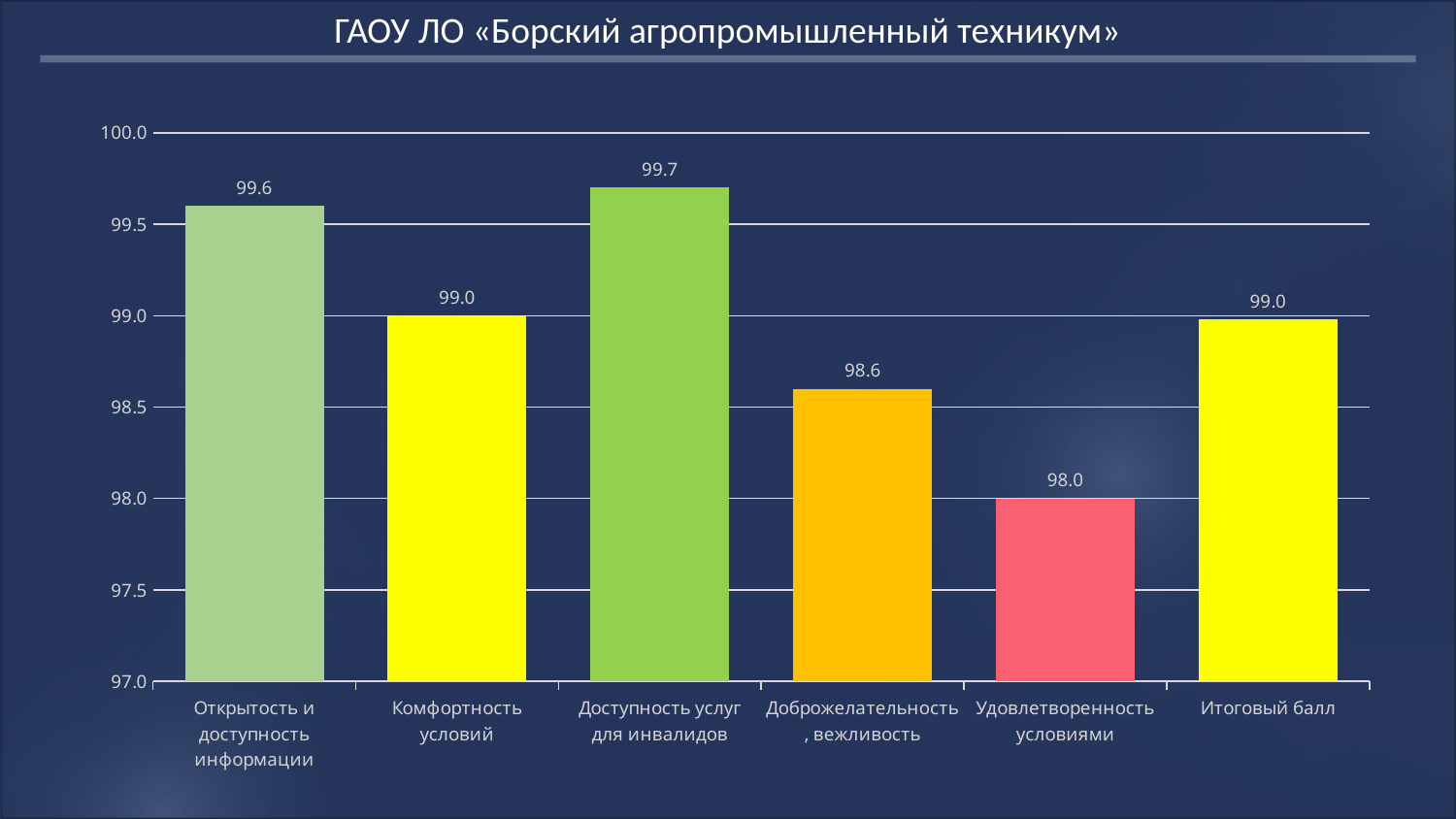
What is the difference between the values for «Доступность услуг для инвалидов» and «Удовлетворенность условиями»? 1.7 Is the value for «Доброжелательность, вежливость» greater or less than 99.0? less Which is larger: the value for «Открытость и доступность информации» or the value for «Доброжелательность, вежливость»? Открытость и доступность информации What colour is the bar for «Удовлетворенность условиями»? red (pink) What is the value for «Удовлетворенность условиями»? 98.0 Which category has the highest value? Доступность услуг для инвалидов What is the value for «Открытость и доступность информации»? 99.6 What is the title of the slide? ГАОУ ЛО «Борский агропромышленный техникум» How many categories are shown on the chart? 6 Which category has the lowest value? Удовлетворенность условиями What kind of chart is shown on the slide? bar chart What is the value for «Итоговый балл»? 99.0